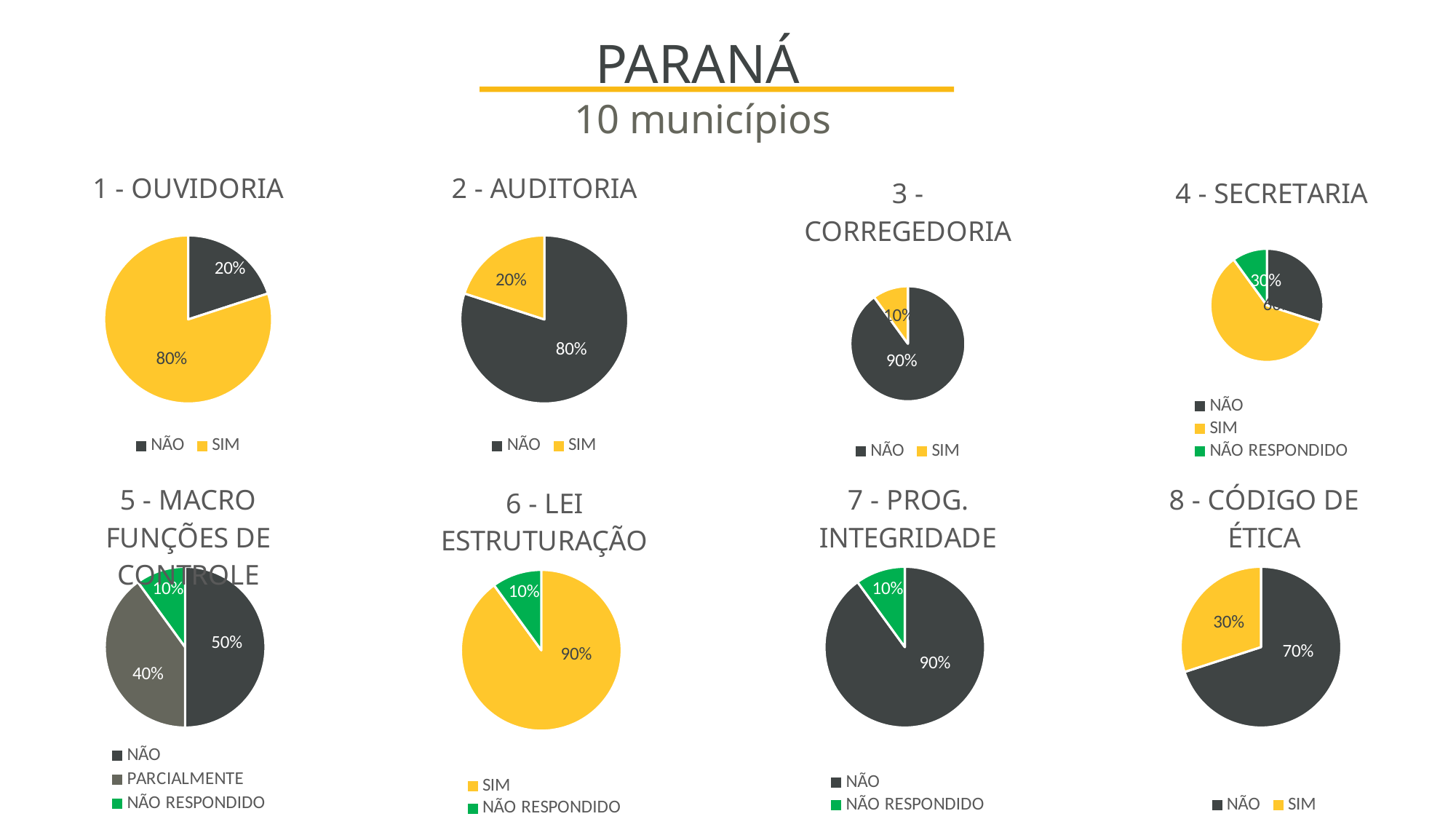
What kind of chart is '7 - PROG. INTEGRIDADE'? Pie chart In the '1 - OUVIDORIA' chart, what share is SIM? 80% In the '2 - AUDITORIA' chart, what share is NÃO? 80% In the '8 - CÓDIGO DE ÉTICA' chart, which is larger, NÃO or SIM? NÃO In the '5 - MACRO FUNÇÕES DE CONTROLE' chart, what share is PARCIALMENTE? 40% In the '5 - MACRO FUNÇÕES DE CONTROLE' chart, which category has the largest slice? NÃO In the '5 - MACRO FUNÇÕES DE CONTROLE' chart, which category has the smallest slice? NÃO RESPONDIDO In the '6 - LEI ESTRUTURAÇÃO' chart, what share is SIM? 90% In the '8 - CÓDIGO DE ÉTICA' chart, what is the difference between the NÃO and SIM shares? 40% In the '3 - CORREGEDORIA' chart, what share is SIM? 10% How many pie charts are shown on the slide? 8 How many categories does the legend of the '4 - SECRETARIA' chart list? 3